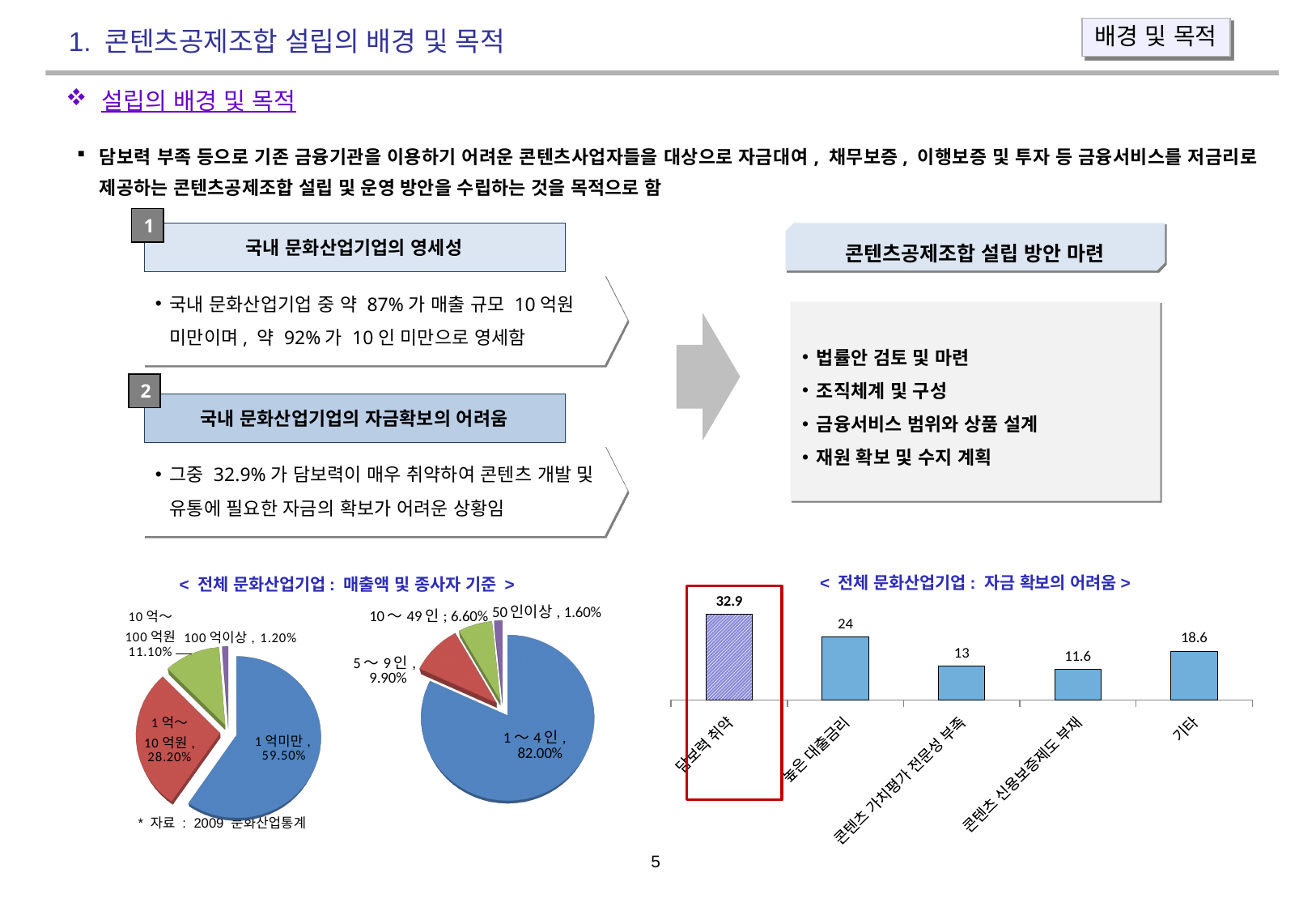
In the bar chart titled '전체 문화산업기업 : 자금 확보의 어려움', which category has the lowest value? 콘텐츠 신용보증제도 부재 In the bar chart titled '전체 문화산업기업 : 자금 확보의 어려움', what is the value for 높은 대출금리? 24 In the bar chart titled '전체 문화산업기업 : 자금 확보의 어려움', which category has the highest value? 담보력 취약 In the left pie chart (매출액 기준), what share does 1억~10억원 have? 28.20% In the bar chart titled '전체 문화산업기업 : 자금 확보의 어려움', what is the difference between 담보력 취약 and 높은 대출금리? 8.9 In the right pie chart (종사자 기준), what share does 1~4인 have? 82.00% In the left pie chart (매출액 기준), what share does 1억미만 have? 59.50% In the bar chart titled '전체 문화산업기업 : 자금 확보의 어려움', what is the value for 담보력 취약? 32.9 In the bar chart titled '전체 문화산업기업 : 자금 확보의 어려움', how many categories are shown? 5 In the bar chart titled '전체 문화산업기업 : 자금 확보의 어려움', which is larger: 기타 or 콘텐츠 가치평가 전문성 부족? 기타 What kind of chart is the chart titled '전체 문화산업기업 : 자금 확보의 어려움'? bar chart In the right pie chart (종사자 기준), which slice is the smallest? 50인이상